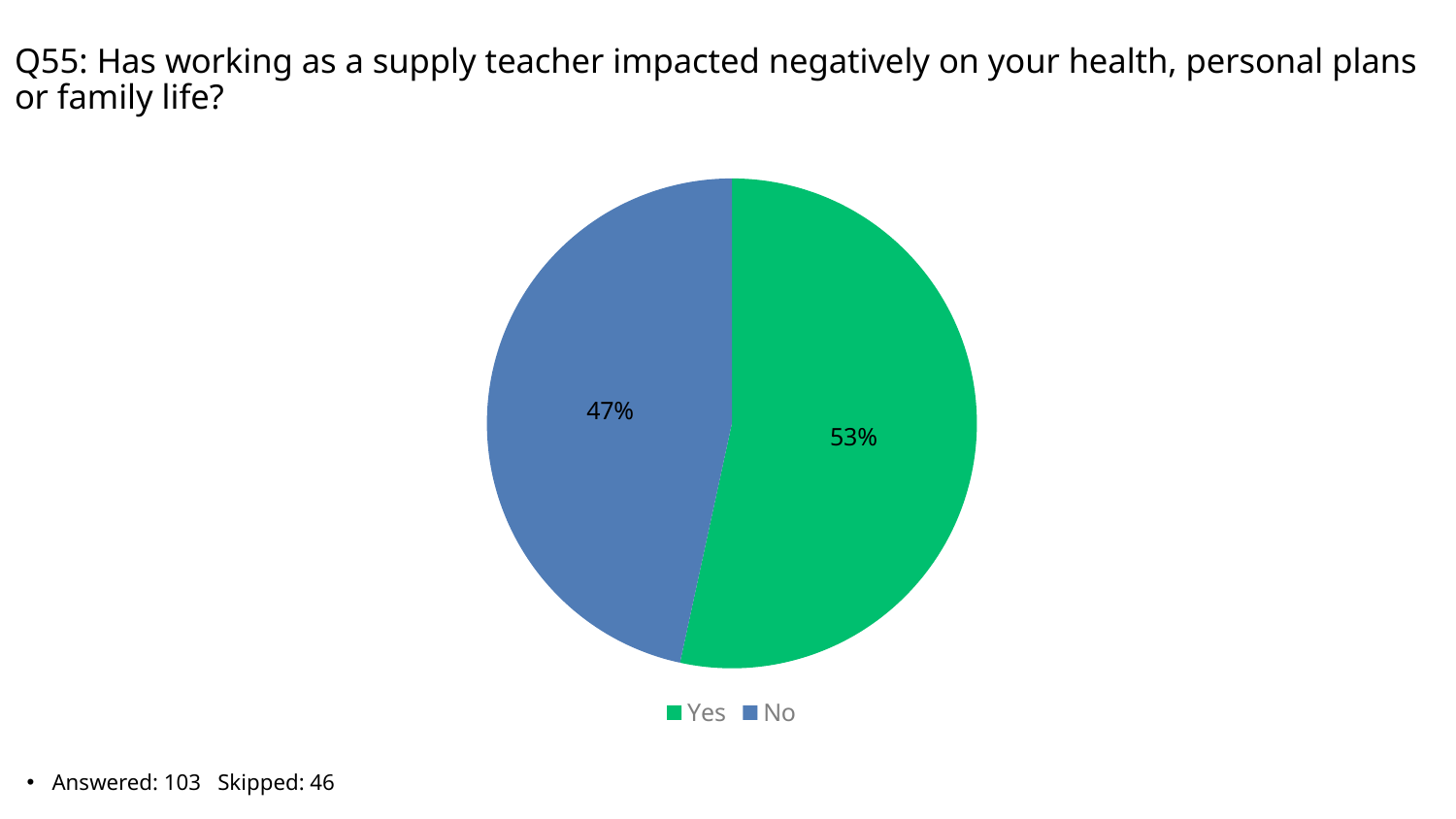
Is the value for "No" greater or less than 50%? less What share of the pie is labelled "No"? 47% Which slice of the pie is the smallest? No What colour is the "Yes" slice? green Which is larger, the "Yes" slice or the "No" slice? Yes How many entries does the legend list? 2 How many respondents answered this question according to the slide? 103 What is the difference in percentage points between the "Yes" and "No" slices? 6 What kind of chart is shown on the slide? pie chart What share of the pie is labelled "Yes"? 53% Which slice of the pie is the largest? Yes How many slices does the pie chart have? 2